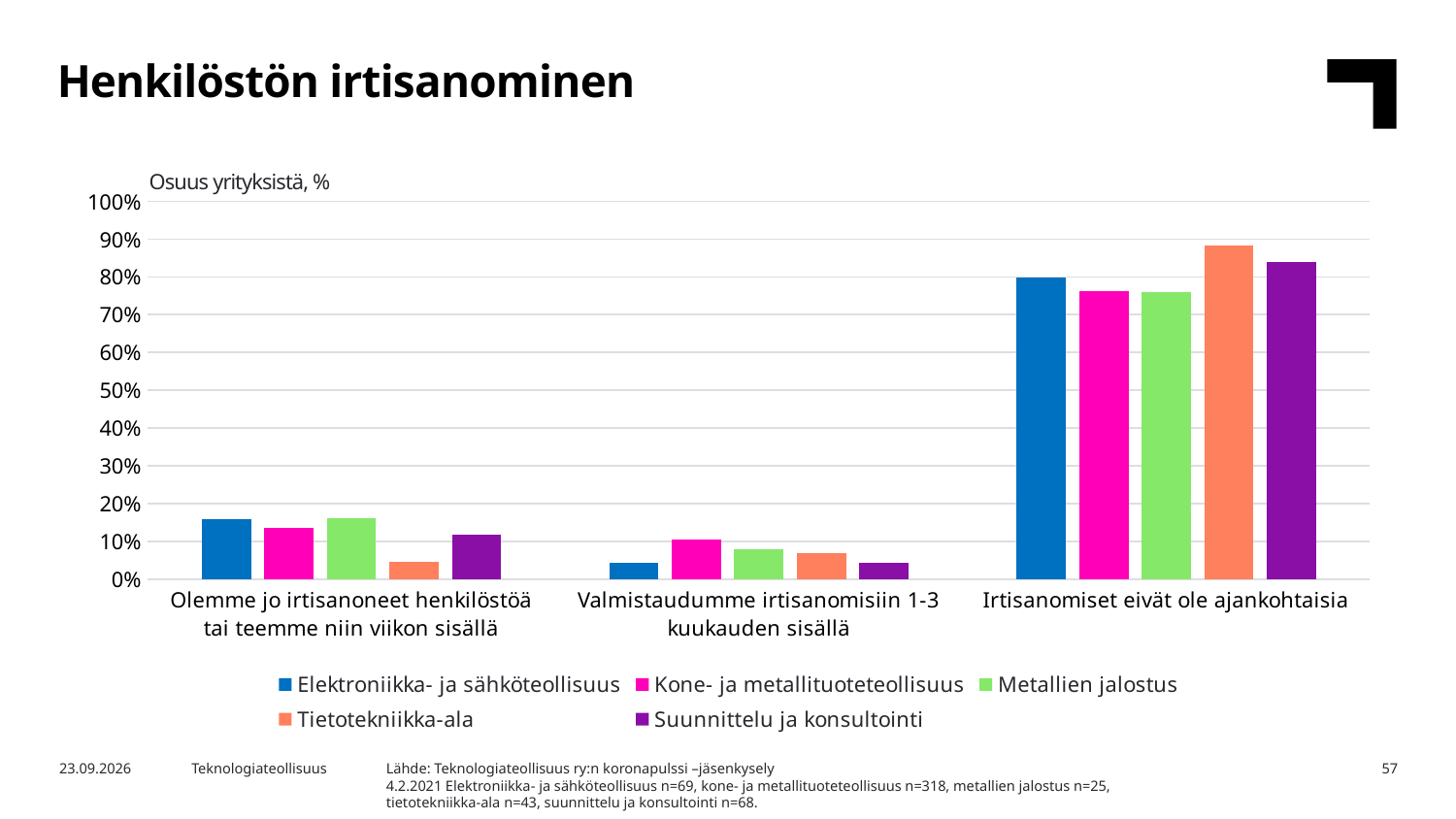
Is the value for Tietotekniikka-ala in 'Olemme jo irtisanoneet henkilöstöä tai teemme niin viikon sisällä' greater or less than 10%? less Which series has the lowest value for 'Olemme jo irtisanoneet henkilöstöä tai teemme niin viikon sisällä'? Tietotekniikka-ala Is the value for Tietotekniikka-ala in 'Irtisanomiset eivät ole ajankohtaisia' greater or less than 80%? greater What is the label shown above the vertical axis of the chart? Osuus yrityksistä, % What kind of chart is shown on the slide? bar chart Is the value for Elektroniikka- ja sähköteollisuus in 'Valmistaudumme irtisanomisiin 1-3 kuukauden sisällä' greater or less than 10%? less How many series does the legend list? 5 In 'Irtisanomiset eivät ole ajankohtaisia', which is larger: Suunnittelu ja konsultointi or Kone- ja metallituoteteollisuus? Suunnittelu ja konsultointi In 'Olemme jo irtisanoneet henkilöstöä tai teemme niin viikon sisällä', which is larger: Elektroniikka- ja sähköteollisuus or Tietotekniikka-ala? Elektroniikka- ja sähköteollisuus How many categories are shown on the x axis? 3 Which series has the highest value for 'Irtisanomiset eivät ole ajankohtaisia'? Tietotekniikka-ala